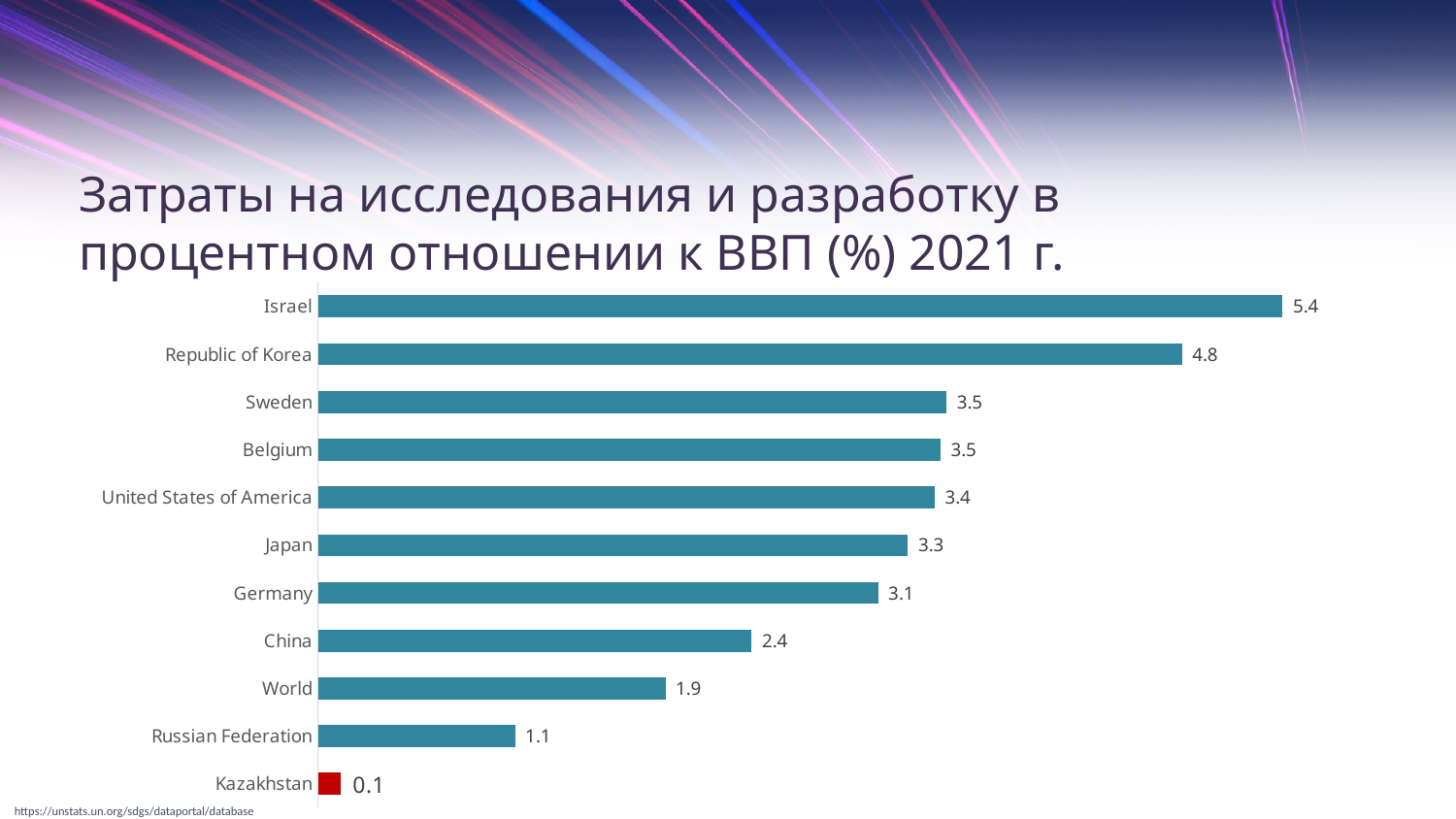
How many categories are shown in the chart? 11 Which is larger, the value for Japan or the value for Germany? Japan What is the value for Israel? 5.4 What is the difference between the values for Israel and Republic of Korea? 0.6 What is the difference between the values for China and Kazakhstan? 2.3 Which category has the lowest value? Kazakhstan Which is larger, the value for World or the value for Russian Federation? World Which category has the highest value? Israel What is the value for Russian Federation? 1.1 What is the value for World? 1.9 Which bar is shown in a different colour (red) from the others? Kazakhstan What kind of chart is shown on the slide? Bar chart